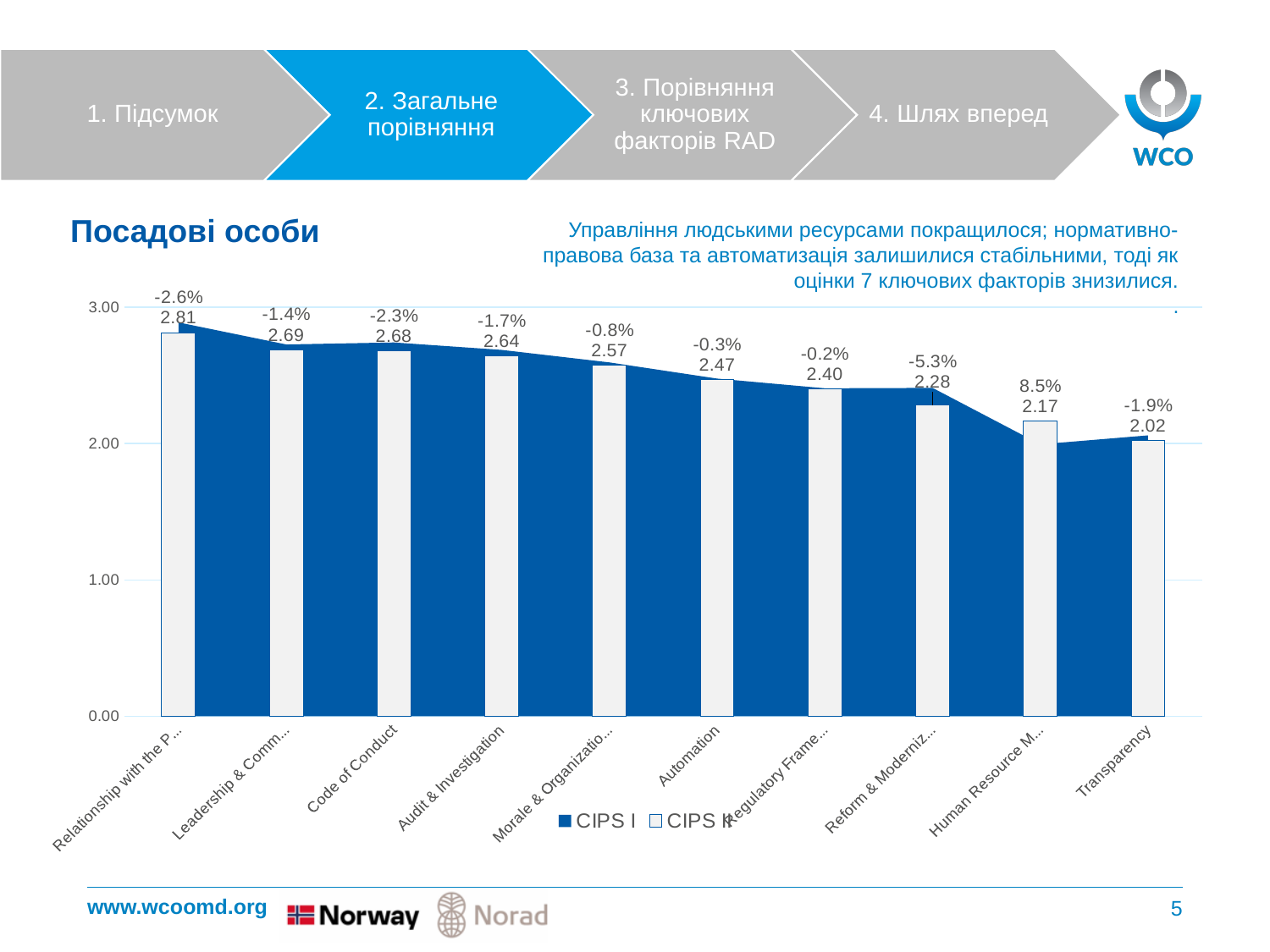
How many categories are shown on the x axis? 10 Which category has the highest labelled value? Relationship with the P... Which has a larger labelled value, Audit & Investigation or Automation? Audit & Investigation What value is labelled above the bar for Code of Conduct? 2.68 What percentage change is shown for Reform & Moderniz...? -5.3% How many series does the legend list? 2 What percentage change is shown for Human Resource M...? 8.5% What value is labelled above the bar for Automation? 2.47 What is the difference between the labelled values for Relationship with the P... (2.81) and Transparency (2.02)? 0.79 Which category has the lowest labelled value? Transparency Do the labelled values rise or fall from left to right along the x axis? fall What are the two series named in the legend? CIPS I and CIPS II